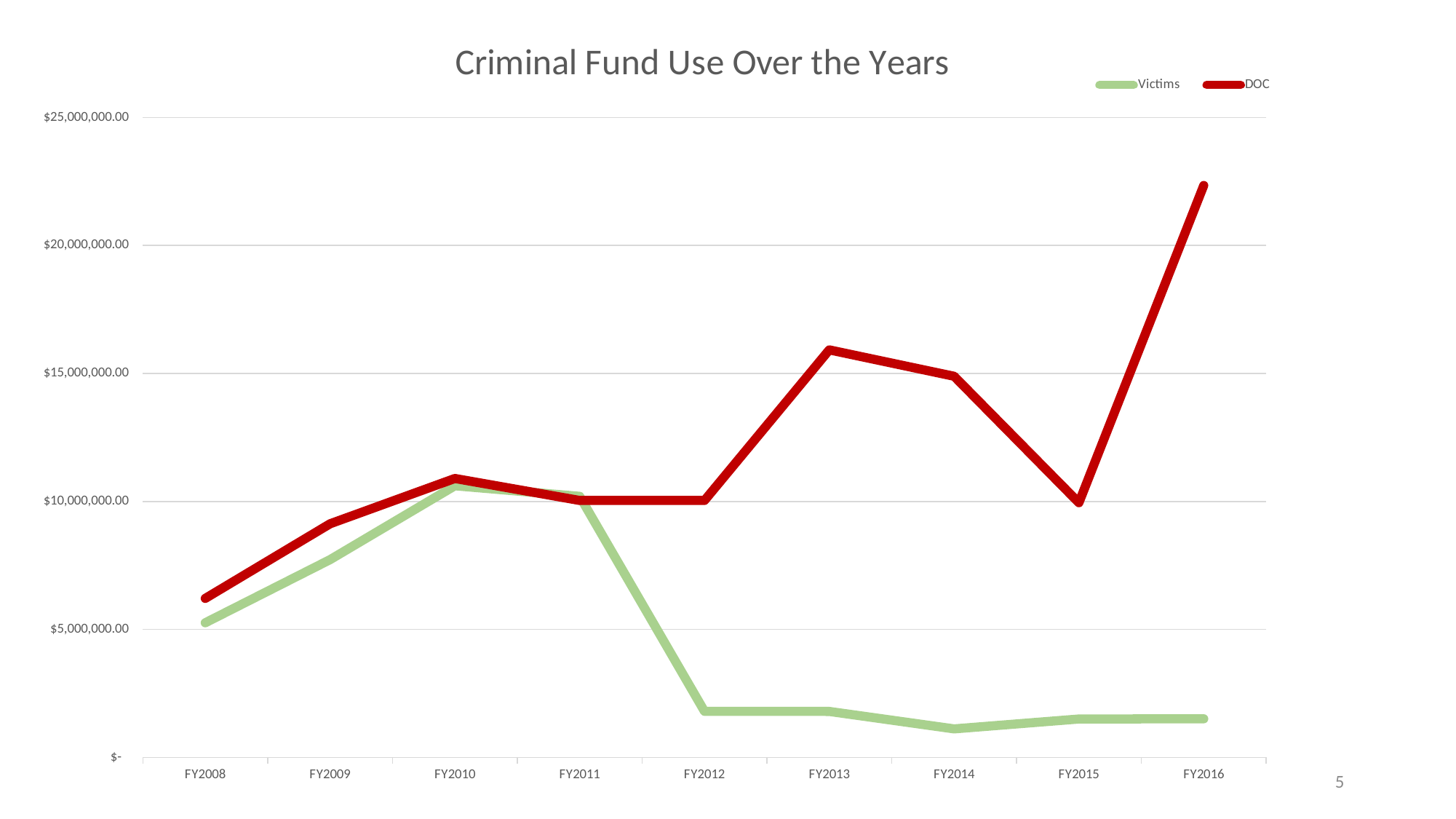
Is the DOC value for FY2013 greater or less than $15,000,000.00? greater How many fiscal years are plotted along the x axis? 9 Does the Victims line rise or fall from FY2011 to FY2012? fall In which fiscal year is the DOC value lowest? FY2008 In which fiscal year is the DOC value highest? FY2016 Is the DOC value for FY2016 greater or less than $20,000,000.00? greater Is the Victims value for FY2012 greater or less than $5,000,000.00? less In which fiscal year is the Victims value lowest? FY2014 What kind of chart is shown on the slide? line chart What is the title of the chart? Criminal Fund Use Over the Years In FY2013, which series has the larger value, Victims or DOC? DOC How many series does the legend list? 2